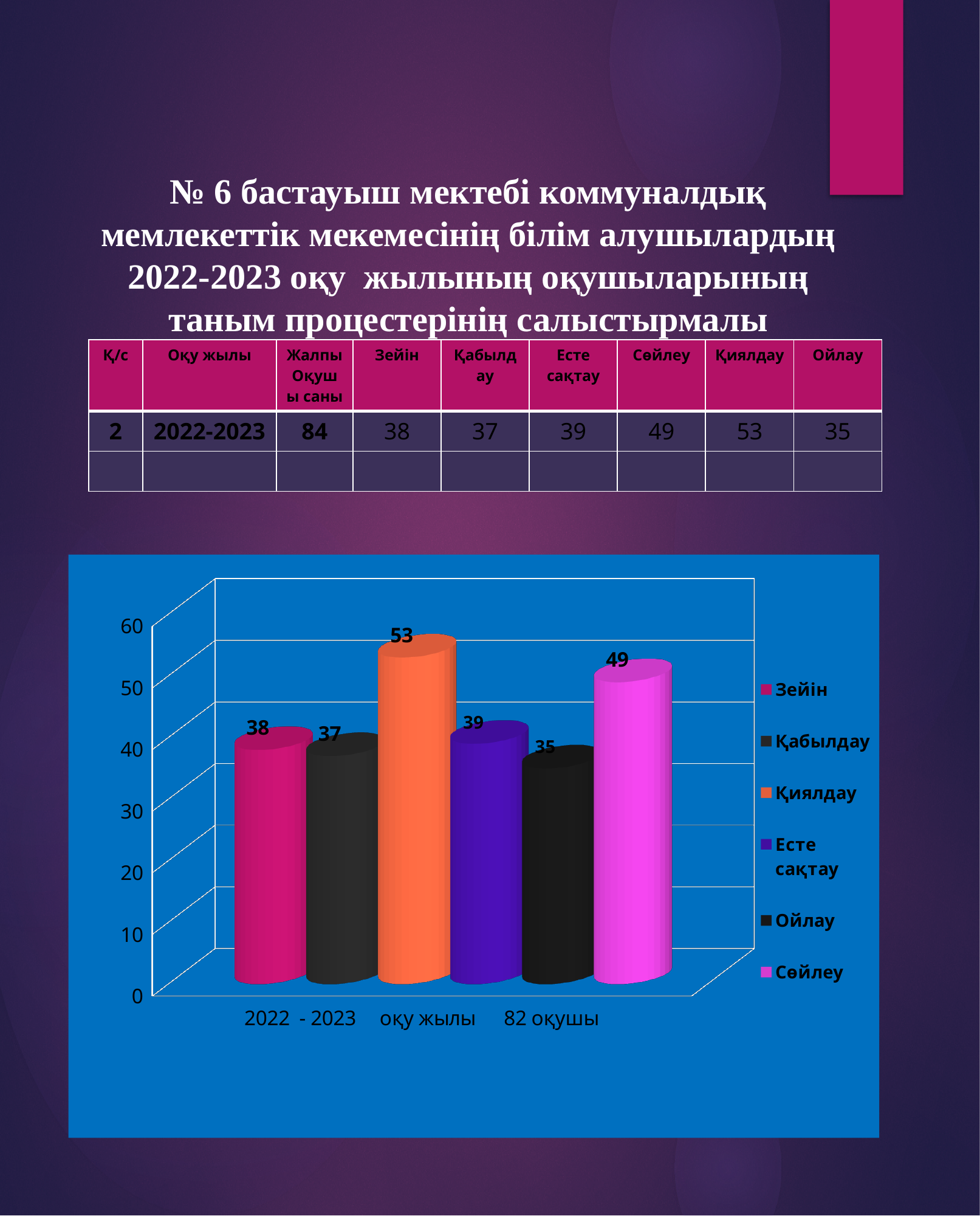
What kind of chart is shown on the slide? bar chart Which is larger, the value for Сөйлеу or the value for Зейін? Сөйлеу How many series does the chart legend list? 6 Which series has the lowest value in the chart? Ойлау What is the difference between the values for Қиялдау and Ойлау? 18 What is the difference between the values for Сөйлеу and Есте сақтау? 10 Which series has the highest value in the chart? Қиялдау What is the value for Зейін in the chart? 38 What is the value for Ойлау in the chart? 35 What is the value for Сөйлеу in the chart? 49 What colour is the bar for Қиялдау in the chart? orange What is the value for Қиялдау in the chart? 53